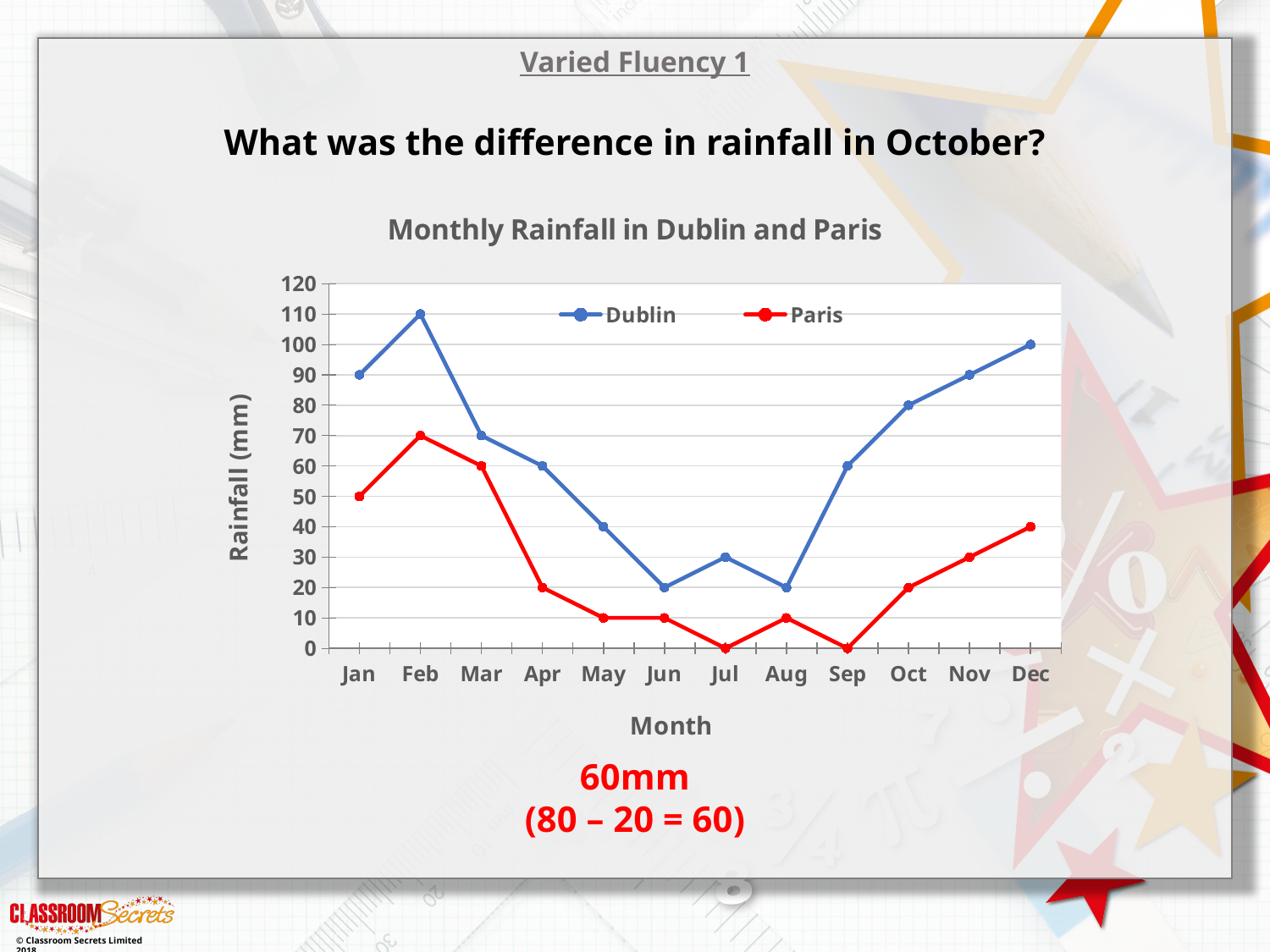
In which month was Dublin's rainfall highest? Feb How many months are plotted along the x axis? 12 What type of chart is shown on the slide? line chart How many series does the legend list? 2 Is the value for Dublin in December greater or less than 90? greater What was the rainfall in Paris in October? 20 Which city had more rainfall in September, Dublin or Paris? Dublin Does Dublin's rainfall rise or fall from September to December? rise What is the title of the chart? Monthly Rainfall in Dublin and Paris What was the rainfall in Dublin in October? 80 What was the rainfall in Paris in February? 70 What was the difference in rainfall between Dublin and Paris in October? 60mm